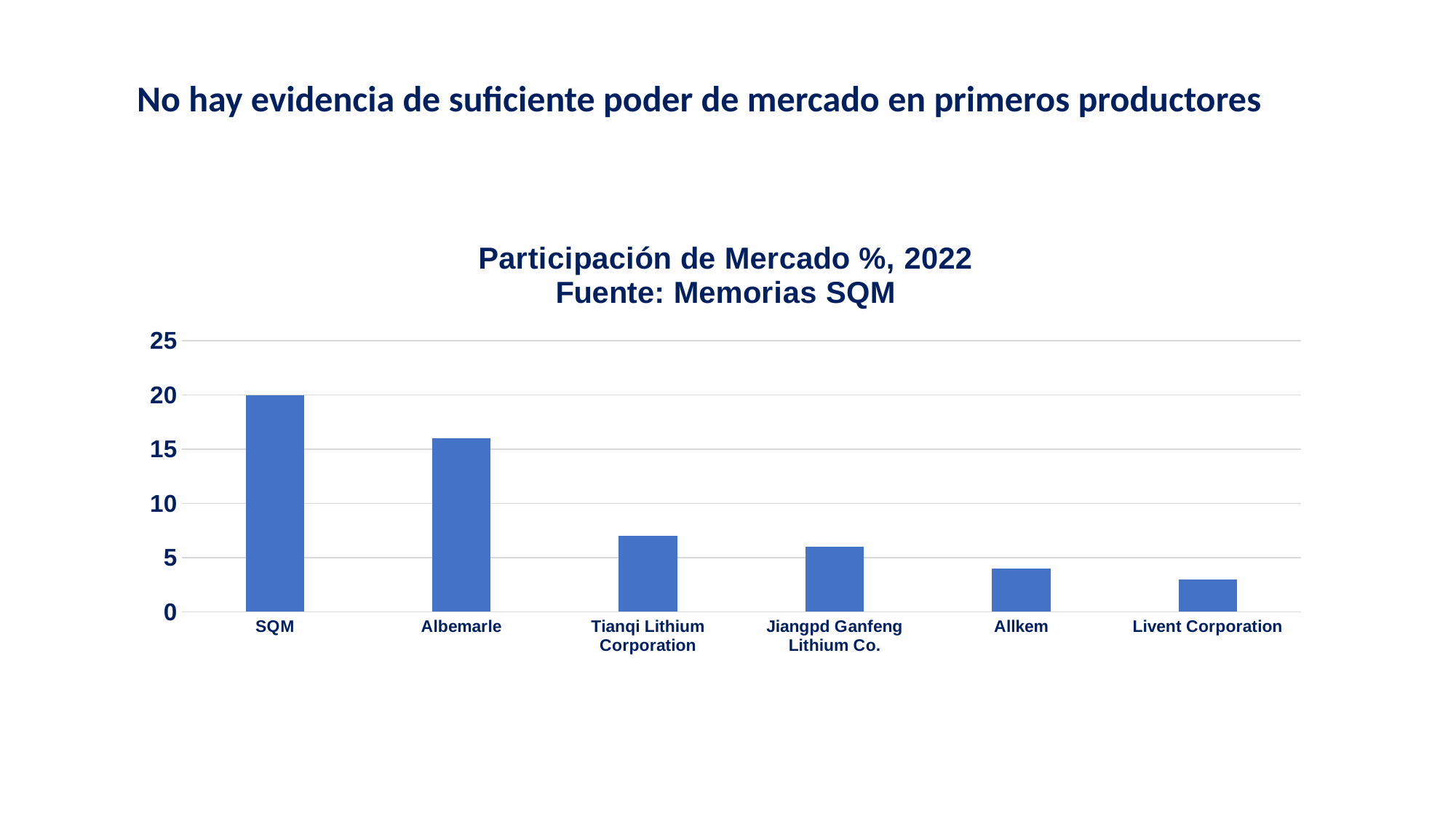
Do the bar values rise or fall from left to right along the x axis? fall What kind of chart is shown on the slide? bar chart Which company has the highest market share in the chart? SQM What is the market share value for SQM? 20 How many companies are shown on the x axis of the chart? 6 Which has a larger market share, Albemarle or Tianqi Lithium Corporation? Albemarle What is the title of the chart? Participación de Mercado %, 2022 Fuente: Memorias SQM Is the value for Tianqi Lithium Corporation greater or less than 10? less Is the value for Jiangpd Ganfeng Lithium Co. greater or less than 5? greater Is the value for Albemarle greater or less than 15? greater Which company has the lowest market share in the chart? Livent Corporation